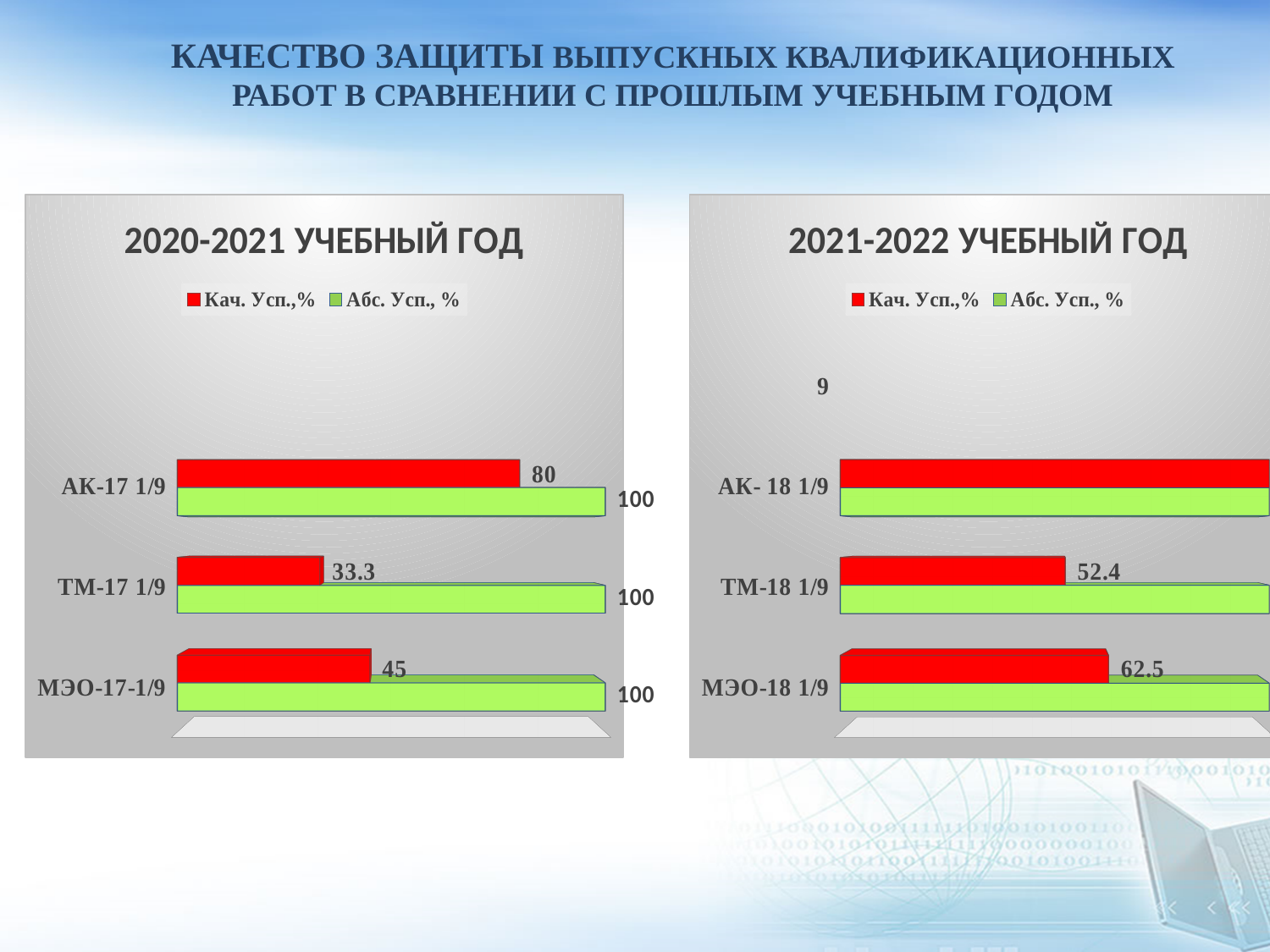
In the 2020-2021 УЧЕБНЫЙ ГОД chart, what is the Кач. Усп.,% value for ТМ-17 1/9? 33.3 In the 2021-2022 УЧЕБНЫЙ ГОД chart, which is larger: the Кач. Усп.,% value for ТМ-18 1/9 or for МЭО-18 1/9? МЭО-18 1/9 In the 2021-2022 УЧЕБНЫЙ ГОД chart, what is the Кач. Усп.,% value for ТМ-18 1/9? 52.4 How many series does the legend of the 2020-2021 УЧЕБНЫЙ ГОД chart list? 2 In the 2020-2021 УЧЕБНЫЙ ГОД chart, what is the difference between the Кач. Усп.,% values for АК-17 1/9 and МЭО-17-1/9? 35 In the 2020-2021 УЧЕБНЫЙ ГОД chart, which group has the highest Кач. Усп.,% value? АК-17 1/9 In the 2020-2021 УЧЕБНЫЙ ГОД chart, which group has the lowest Кач. Усп.,% value? ТМ-17 1/9 What type of chart is the 2020-2021 УЧЕБНЫЙ ГОД chart? Bar chart In the 2020-2021 УЧЕБНЫЙ ГОД chart, what is the Абс. Усп., % value for МЭО-17-1/9? 100 In the 2020-2021 УЧЕБНЫЙ ГОД chart, what is the Кач. Усп.,% value for АК-17 1/9? 80 How many groups are shown in the 2021-2022 УЧЕБНЫЙ ГОД chart? 3 In the 2021-2022 УЧЕБНЫЙ ГОД chart, what is the Кач. Усп.,% value for МЭО-18 1/9? 62.5